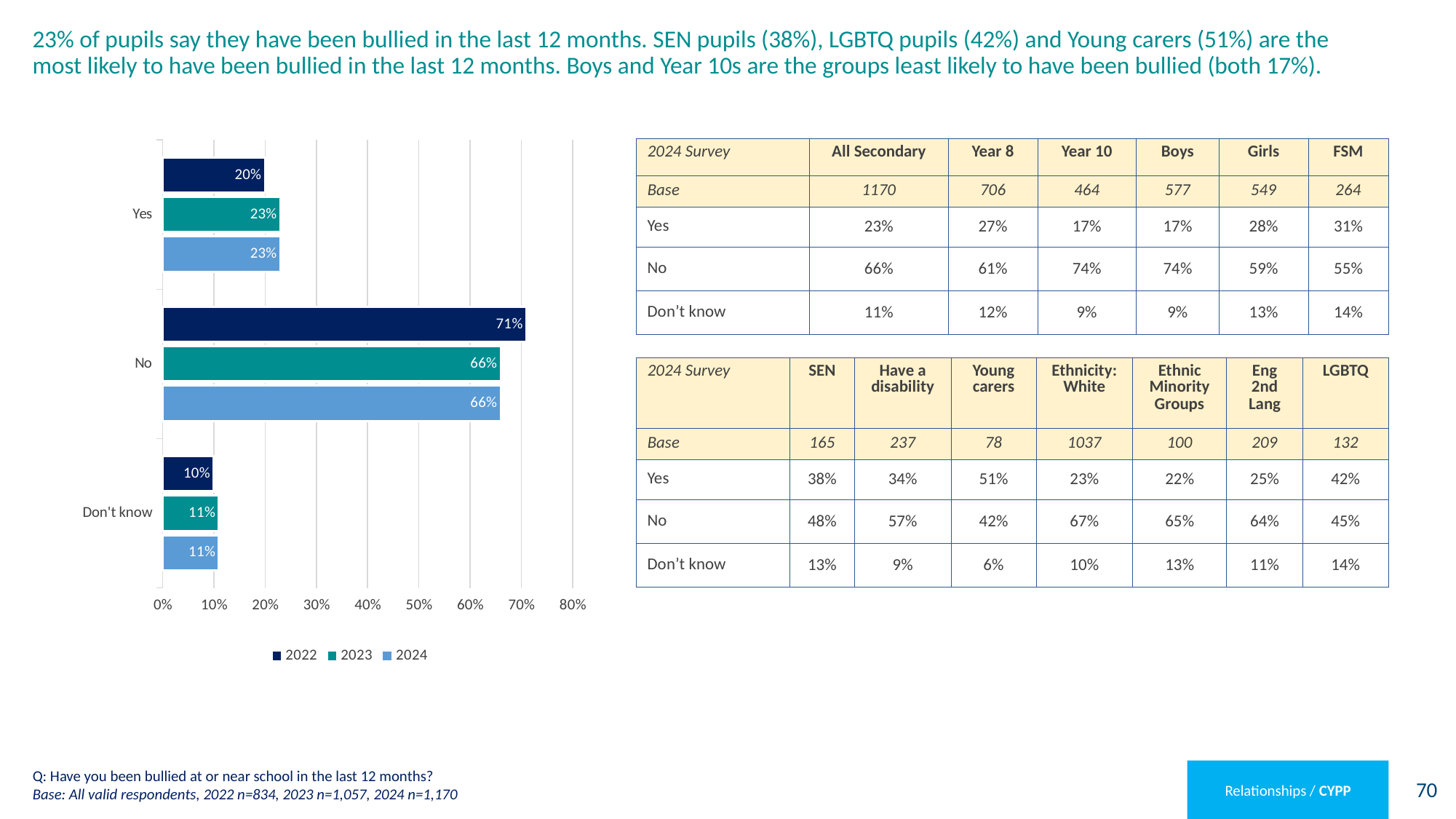
What is the value for 'Don't know' in the 2023 series? 11% Which category has the lowest value in the 2022 series? Don't know What is the value for 'Yes' in the 2024 series? 23% What kind of chart is shown on the slide? Bar chart What is the difference between the 2022 and 2024 values for 'No'? 5% Which category has the highest value in the 2024 series? No Which is larger: the 2022 value for 'Yes' or the 2023 value for 'Yes'? 2023 What is the difference between the 2022 and 2023 values for 'Yes'? 3% What is the value for 'No' in the 2022 series? 71% How many series does the legend list? 3 How many categories are shown on the chart? 3 What is the value for 'Don't know' in the 2022 series? 10%